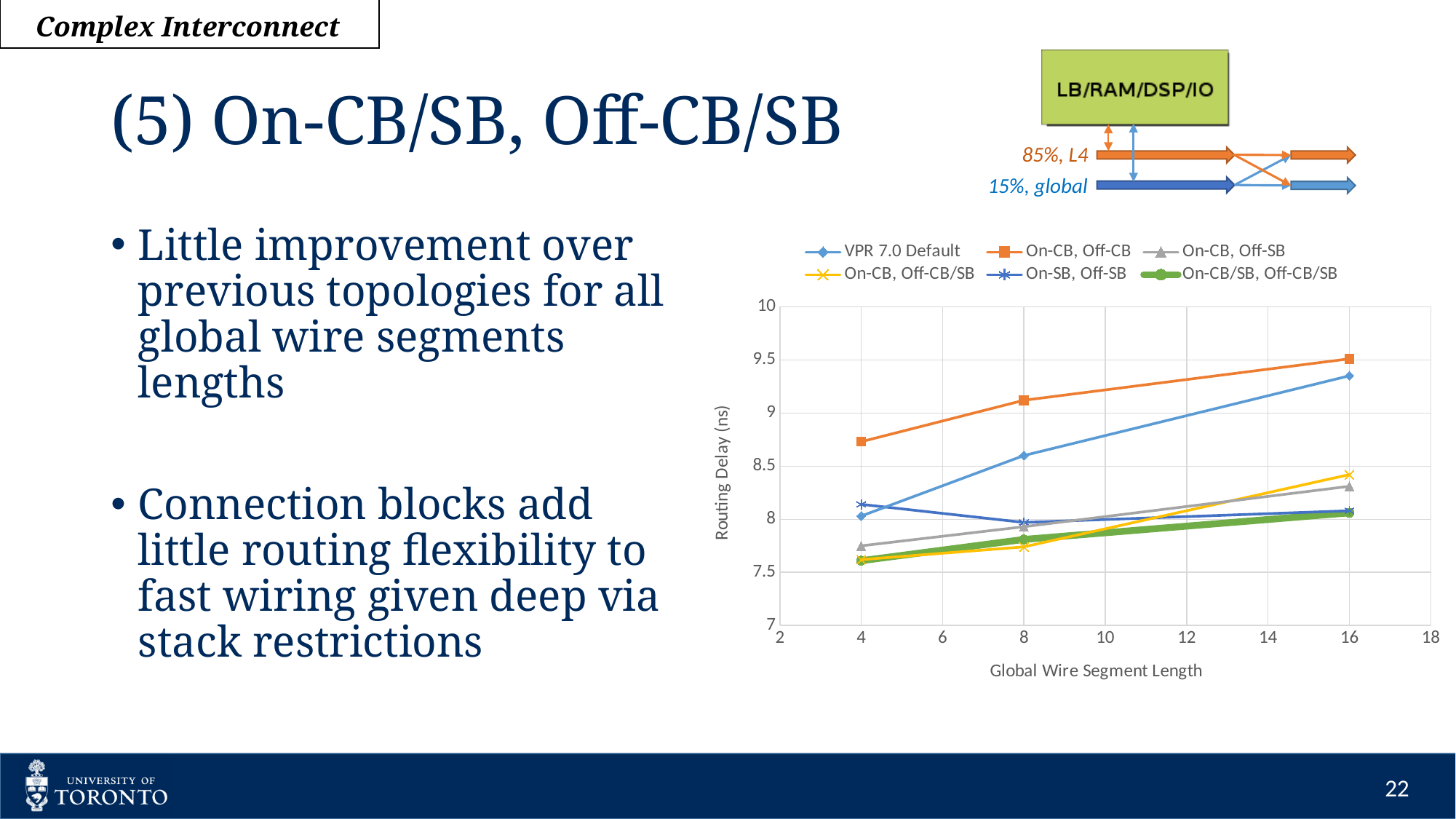
Is the routing delay for On-CB, Off-CB/SB at segment length 4 greater or less than 8? less Is the routing delay for On-CB, Off-CB at segment length 4 greater or less than 8.5? greater How many series does the chart's legend list? 6 Is the routing delay for VPR 7.0 Default at segment length 16 greater or less than 9? greater What is the label of the x axis? Global Wire Segment Length How many global wire segment lengths are plotted for each series? 3 What is the label of the y axis? Routing Delay (ns) What kind of chart is shown on the slide? line chart Does the routing delay for On-CB, Off-CB rise or fall as global wire segment length increases? rise Which series has the highest routing delay at a global wire segment length of 16? On-CB, Off-CB At segment length 8, which has the larger routing delay: VPR 7.0 Default or On-CB, Off-SB? VPR 7.0 Default Which series has the highest routing delay at a global wire segment length of 4? On-CB, Off-CB